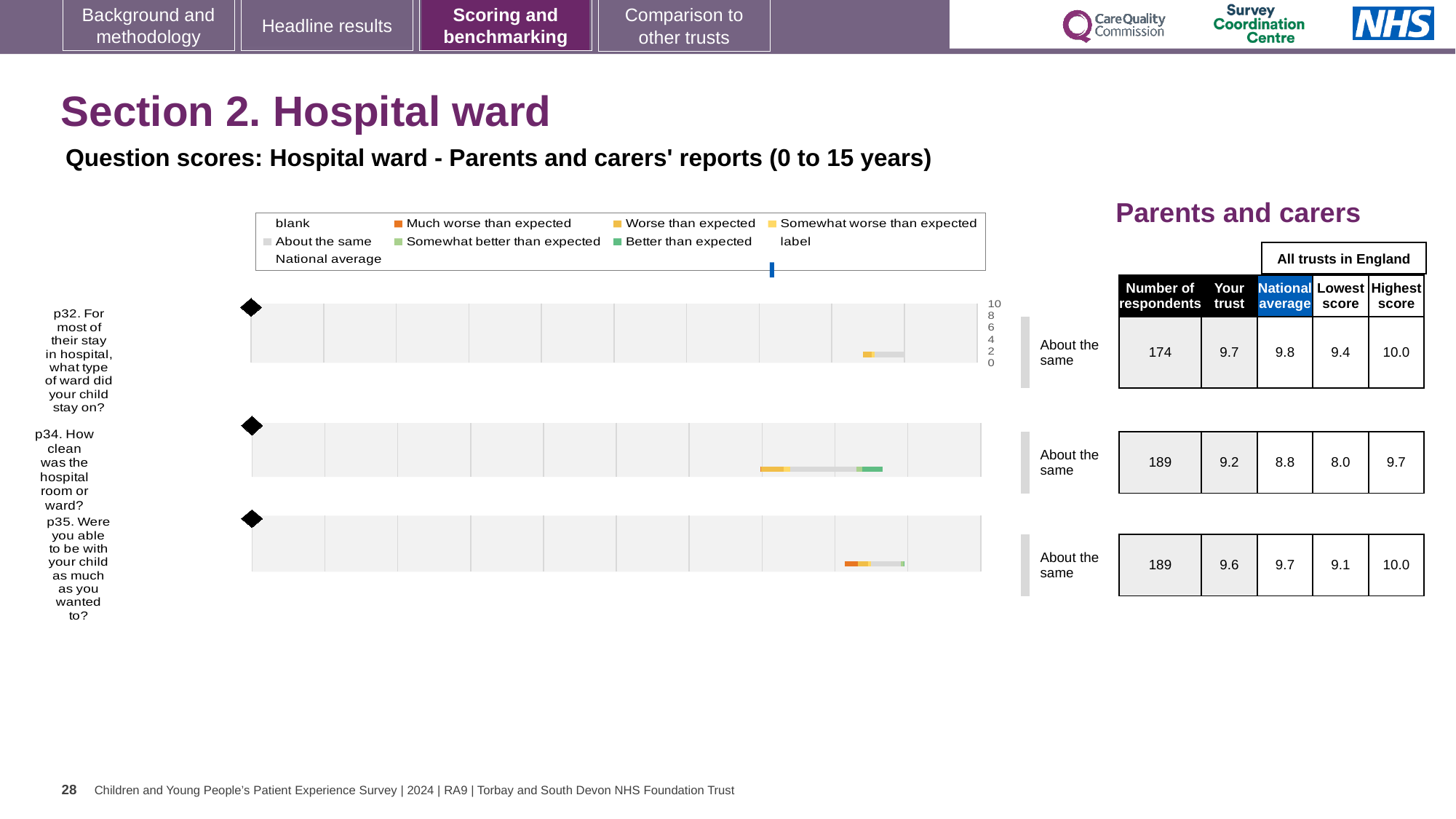
What kind of chart is used to show the question scores? bar chart What is the lowest score among all trusts in England for p34? 8.0 Which question has the lowest 'Your trust' score? p34 What is the national average score for p32 (For most of their stay in hospital, what type of ward did your child stay on?)? 9.8 How many respondents answered p32? 174 Which question has the highest 'Your trust' score? p32 What is the highest score among all trusts in England for p35 (Were you able to be with your child as much as you wanted to?)? 10.0 What is the 'Your trust' score for p34 (How clean was the hospital room or ward?)? 9.2 What benchmark category is shown for p34 (How clean was the hospital room or ward?)? About the same For p35, is the 'Your trust' score higher or lower than the national average? lower How many questions are plotted on this slide? 3 What is the difference between the 'Your trust' score and the national average for p34? 0.4